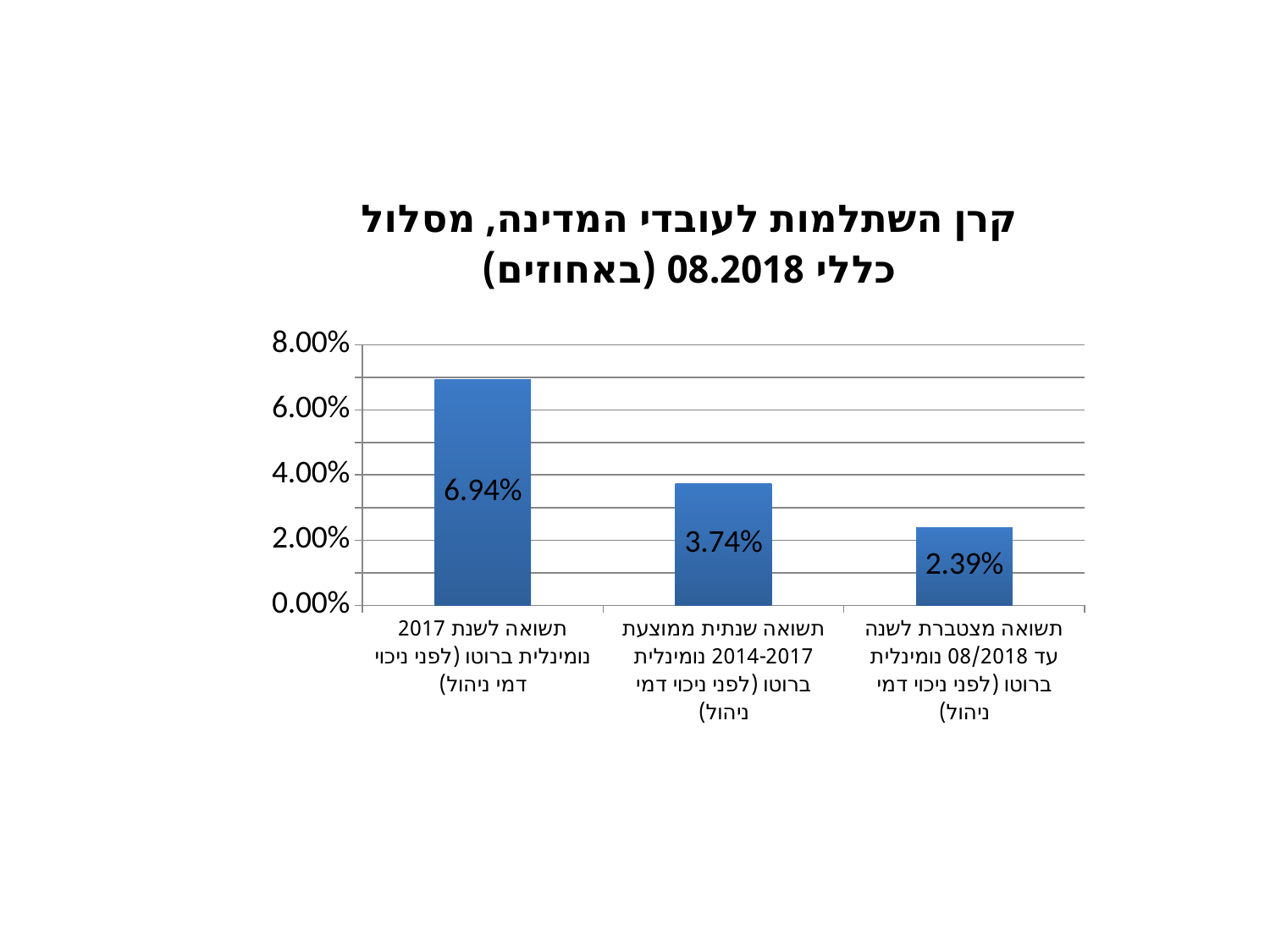
What kind of chart is shown on the slide? bar chart Is the value for the 2017 return (תשואה לשנת 2017) greater or less than 6.00%? greater What is the difference between the value for 2017 (תשואה לשנת 2017) and the average annual return for 2014-2017 (תשואה שנתית ממוצעת 2014-2017)? 3.20% Which category has the lowest value? תשואה מצטברת לשנה עד 08/2018 נומינלית ברוטו (לפני ניכוי דמי ניהול) What is the value for the bar labelled "תשואה שנתית ממוצעת 2014-2017 נומינלית ברוטו (לפני ניכוי דמי ניהול)"? 3.74% What is the value for the bar labelled "תשואה לשנת 2017 נומינלית ברוטו (לפני ניכוי דמי ניהול)"? 6.94% What is the difference between the average annual return for 2014-2017 (תשואה שנתית ממוצעת 2014-2017) and the cumulative return to 08/2018 (תשואה מצטברת לשנה עד 08/2018)? 1.35% How many bars are shown in the chart? 3 What is the value for the bar labelled "תשואה מצטברת לשנה עד 08/2018 נומינלית ברוטו (לפני ניכוי דמי ניהול)"? 2.39% Which category has the highest value? תשואה לשנת 2017 נומינלית ברוטו (לפני ניכוי דמי ניהול) What is the title of the chart? קרן השתלמות לעובדי המדינה, מסלול כללי 08.2018 (באחוזים) Which is larger: the value for 2017 (תשואה לשנת 2017) or the cumulative return to 08/2018 (תשואה מצטברת לשנה עד 08/2018)? תשואה לשנת 2017 נומינלית ברוטו (לפני ניכוי דמי ניהול)